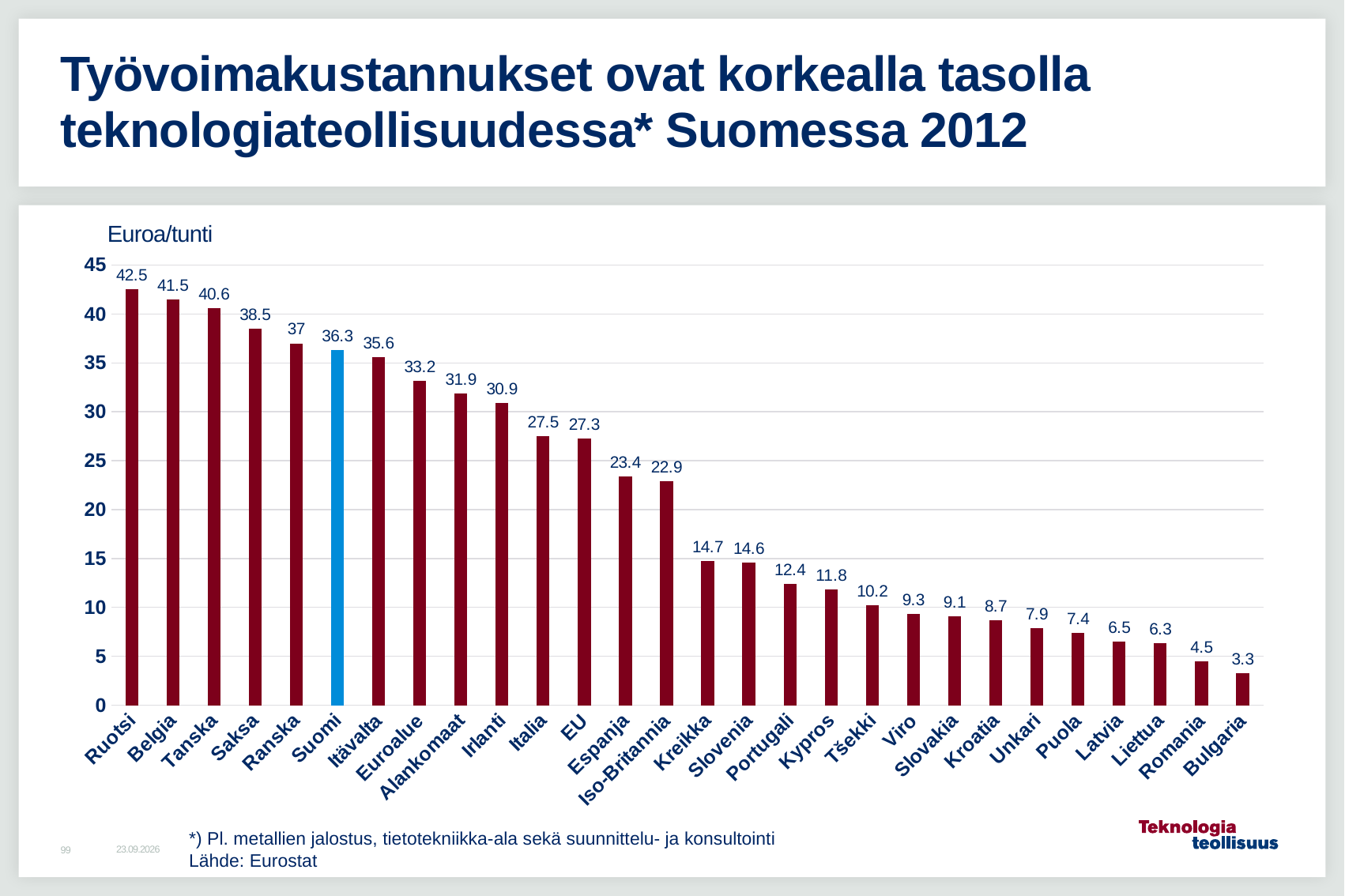
What kind of chart is shown on the slide? bar chart What unit is shown above the y axis? Euroa/tunti What is the value for Suomi? 36.3 What is the difference between the values for Ruotsi and Suomi? 6.2 What is the difference between the values for Euroalue and EU? 5.9 Which country has the highest value? Ruotsi Which country has the lowest value? Bulgaria What is the value for Iso-Britannia? 22.9 What is the value for Saksa? 38.5 Is the value for Kreikka greater or less than 15? less Which is larger, the value for Belgia or the value for Tanska? Belgia How many countries or regions are shown on the x axis? 28